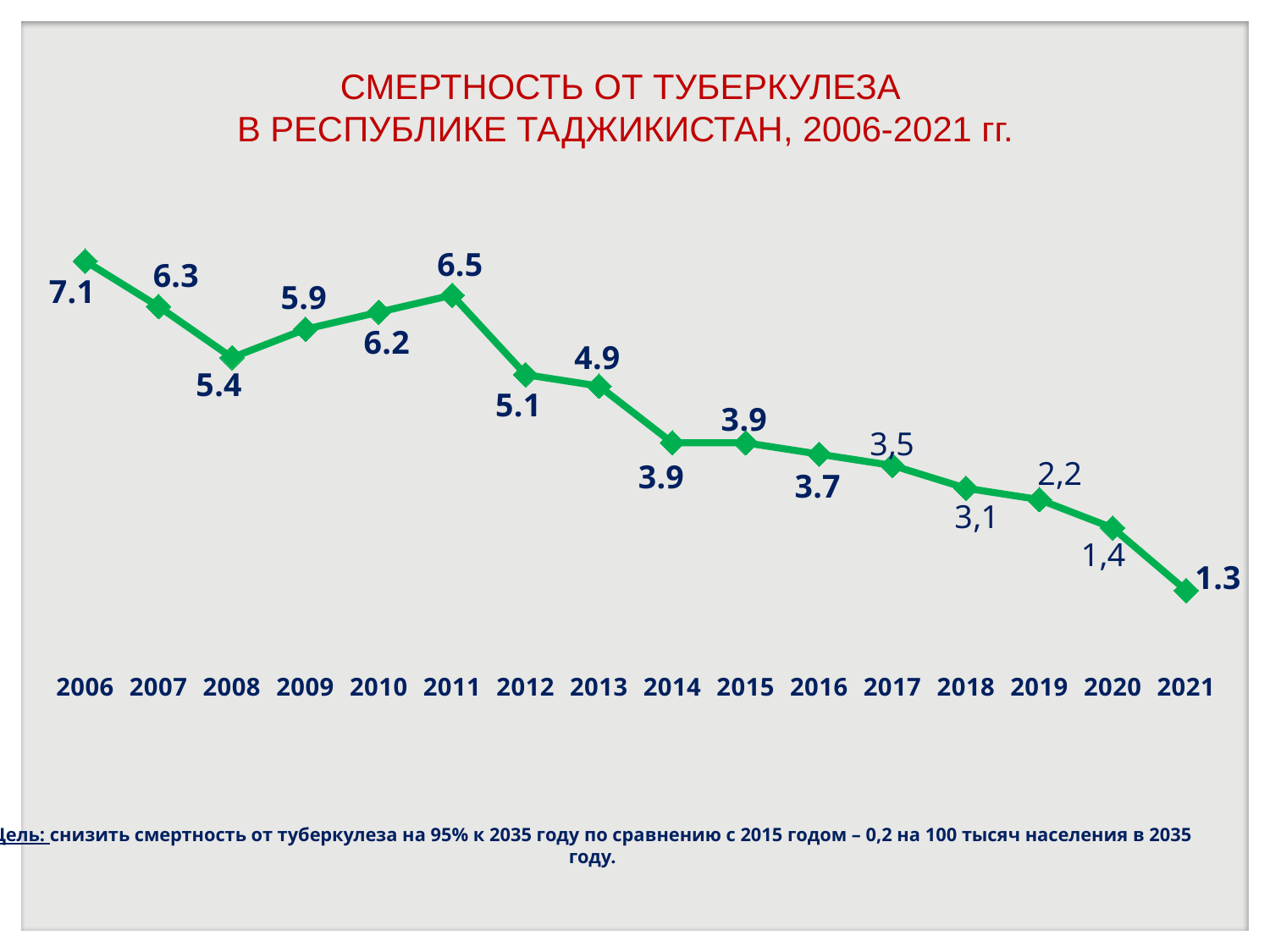
What is the tuberculosis mortality value for 2006? 7.1 What type of chart is shown on the slide? line chart What is the value shown for 2021? 1.3 What is the difference between the values for 2006 and 2021? 5.8 Overall, do the values rise or fall from 2006 to 2021? fall How many years (data points) are plotted on the chart? 16 What is the value shown for 2011? 6.5 What is the title of the chart? СМЕРТНОСТЬ ОТ ТУБЕРКУЛЕЗА В РЕСПУБЛИКЕ ТАДЖИКИСТАН, 2006-2021 гг. Which year has the highest value on the chart? 2006 Which year has the lowest value on the chart? 2021 Which year has the larger value, 2008 or 2010? 2010 What is the value shown for 2019? 2,2